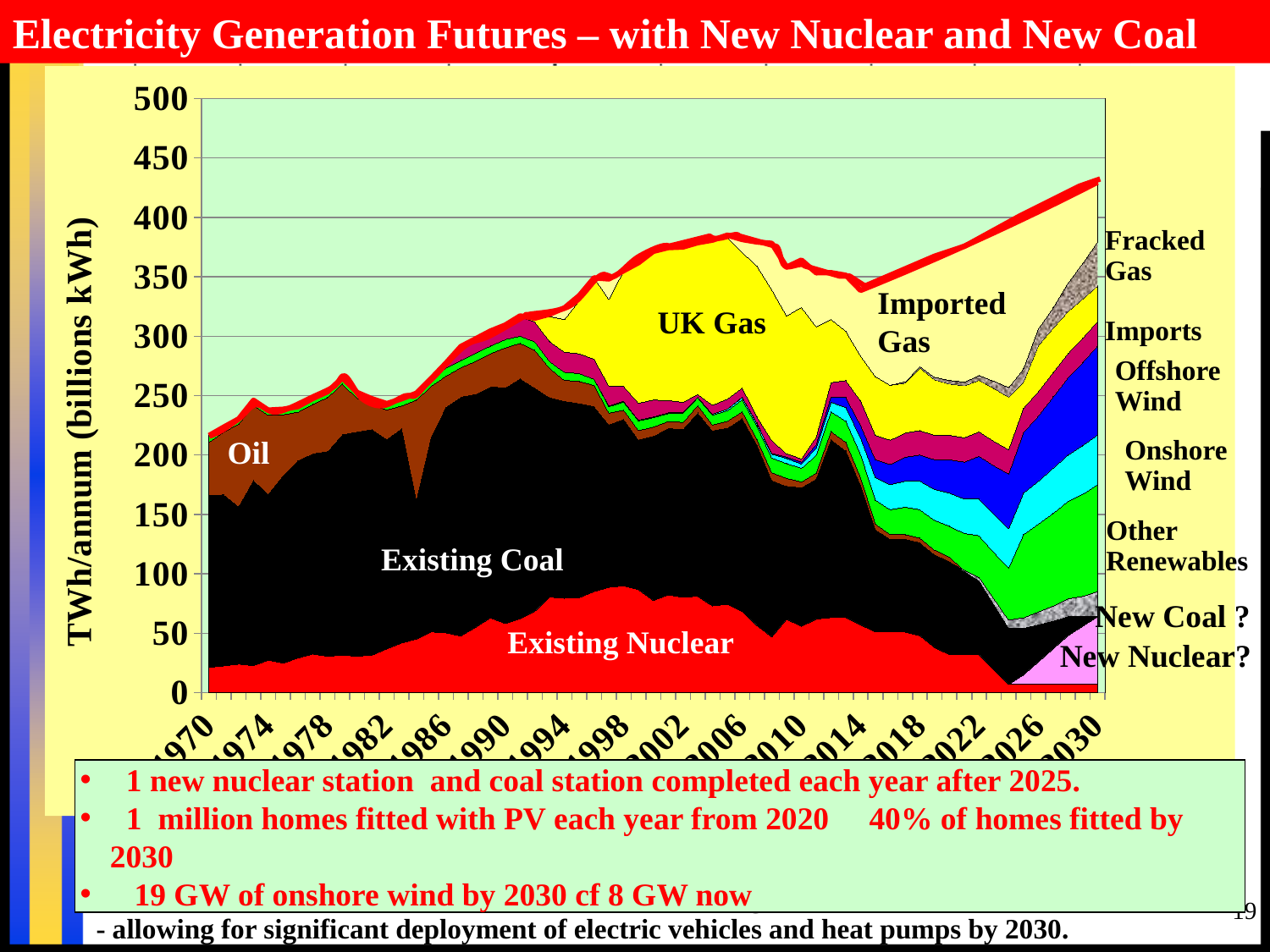
Is the total electricity generation shown for 1970 greater or less than 250 TWh/annum? less How many year labels are shown along the x axis? 16 What kind of chart is shown on the slide? Stacked area chart Which year has the larger total generation, 1970 or 2030? 2030 In which year shown on the x axis does the total generation reach its highest value? 2030 Is the Existing Nuclear generation in 1970 greater or less than 50 TWh/annum? less What is the title of the slide containing the chart? Electricity Generation Futures – with New Nuclear and New Coal Is the total electricity generation shown for 2030 greater or less than 400 TWh/annum? greater What is the label on the vertical axis of the chart? TWh/annum (billions kWh) Does the total generation rise or fall between 2018 and 2030? Rise